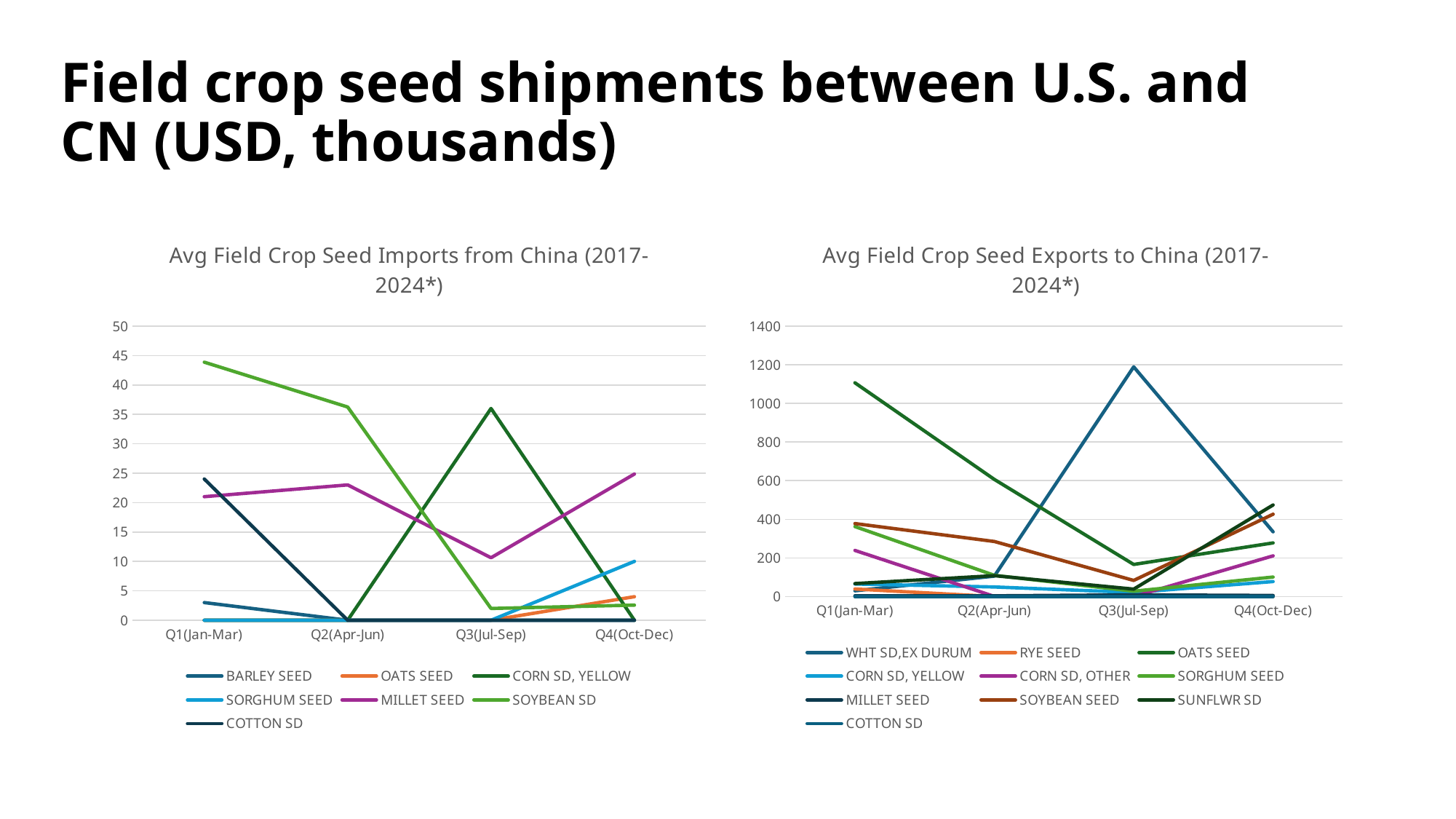
How many series does the legend of the 'Avg Field Crop Seed Imports from China (2017-2024*)' chart list? 7 In the 'Avg Field Crop Seed Imports from China (2017-2024*)' chart, is the value for SOYBEAN SD in Q1(Jan-Mar) greater or less than 40? greater How many series does the legend of the 'Avg Field Crop Seed Exports to China (2017-2024*)' chart list? 10 In the 'Avg Field Crop Seed Exports to China (2017-2024*)' chart, which series has the highest value in Q1(Jan-Mar)? OATS SEED In the 'Avg Field Crop Seed Imports from China (2017-2024*)' chart, which series has the highest value in Q1(Jan-Mar)? SOYBEAN SD In the 'Avg Field Crop Seed Imports from China (2017-2024*)' chart, does the SOYBEAN SD line rise or fall from Q1(Jan-Mar) to Q3(Jul-Sep)? fall In the 'Avg Field Crop Seed Exports to China (2017-2024*)' chart, is the value for WHT SD,EX DURUM in Q3(Jul-Sep) greater or less than 1000? greater What kind of chart is the 'Avg Field Crop Seed Imports from China (2017-2024*)' chart? line chart In the 'Avg Field Crop Seed Exports to China (2017-2024*)' chart, which series has the highest value in Q3(Jul-Sep)? WHT SD,EX DURUM In the 'Avg Field Crop Seed Imports from China (2017-2024*)' chart, which is larger in Q4(Oct-Dec): MILLET SEED or SOYBEAN SD? MILLET SEED In the 'Avg Field Crop Seed Imports from China (2017-2024*)' chart, is the value for CORN SD, YELLOW in Q3(Jul-Sep) greater or less than 30? greater How many quarters are shown on the x axis of the 'Avg Field Crop Seed Exports to China (2017-2024*)' chart? 4